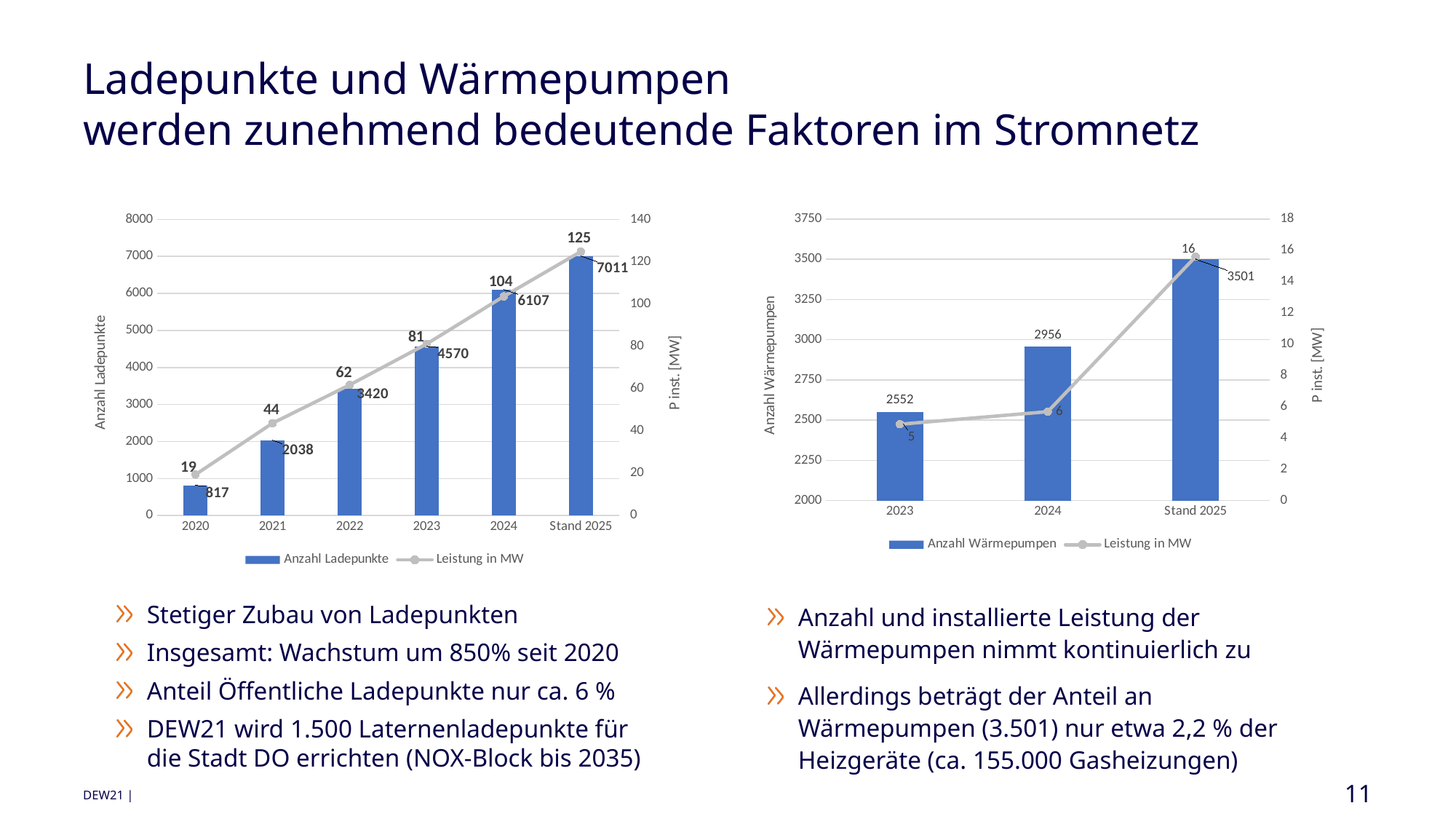
In the left chart, how many categories are shown on the x axis? 6 In the right chart, how many series does the legend list? 2 In the right chart, which category has the highest Anzahl Wärmepumpen? Stand 2025 In the right chart, what is the Anzahl Wärmepumpen for 2024? 2956 In the left chart, what is the Leistung in MW for 2024? 104 In the left chart, what is the value of Anzahl Ladepunkte for 2022? 3420 In the left chart, which year has the lowest Anzahl Ladepunkte? 2020 In the left chart, what is the difference in Anzahl Ladepunkte between Stand 2025 and 2020? 6194 In the right chart, what is the Leistung in MW for Stand 2025? 16 In the left chart, does the Leistung in MW rise or fall from 2020 to Stand 2025? rise What type of chart is the left chart? Combined bar and line chart In the right chart, what is the difference in Leistung in MW between Stand 2025 and 2024? 10